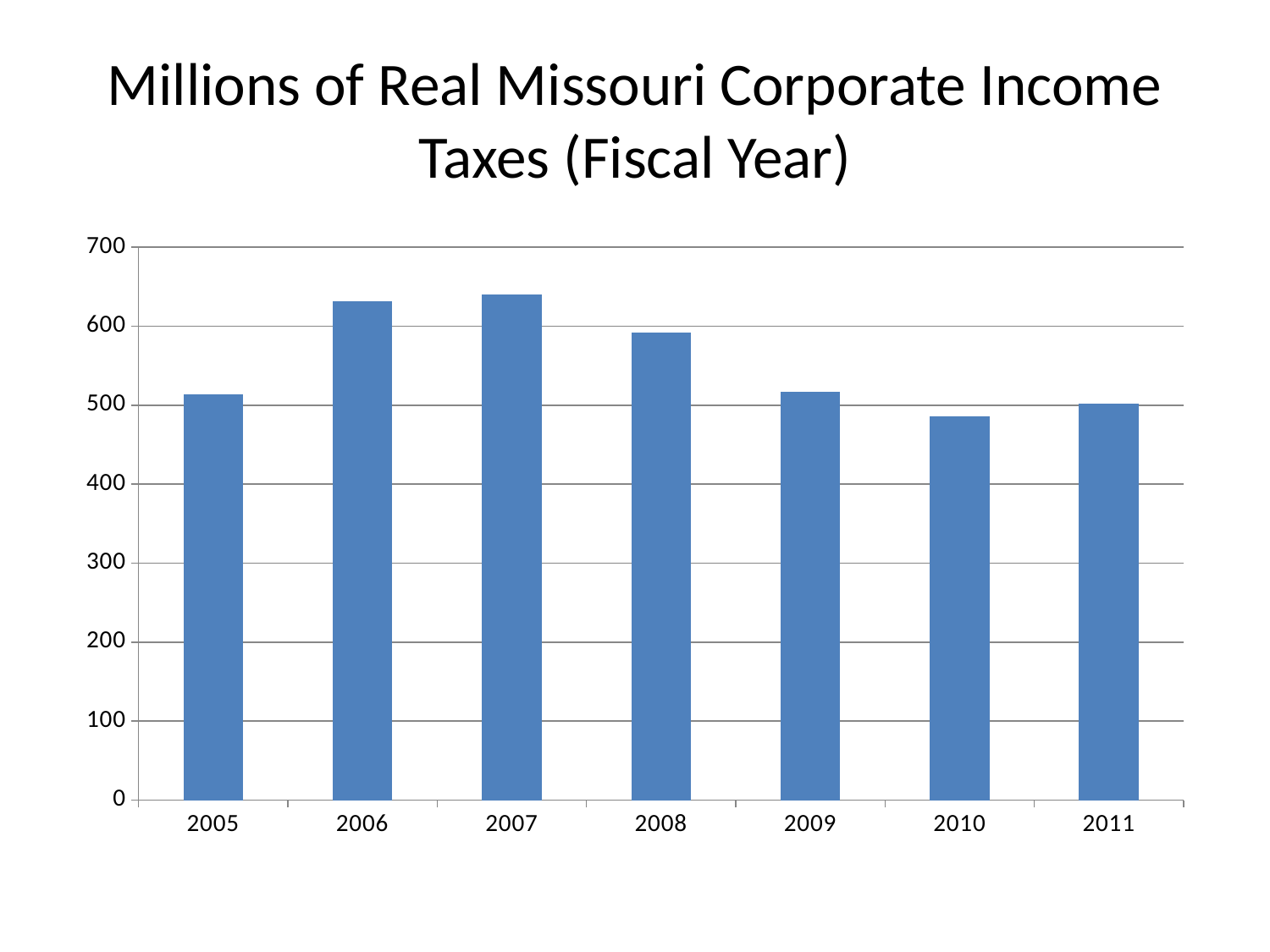
Which is larger, the value for 2006 or the value for 2009? 2006 Is the value for 2009 greater or less than 500? greater Which is larger, the value for 2005 or the value for 2008? 2008 What kind of chart is shown on the slide? Bar chart Do the values rise or fall from 2007 to 2010? fall Which fiscal year has the highest value in the chart? 2007 What is the title of the chart? Millions of Real Missouri Corporate Income Taxes (Fiscal Year) Is the value for 2006 greater or less than 600? greater Is the value for 2010 greater or less than 500? less How many fiscal years are shown on the x axis of the chart? 7 Which fiscal year has the lowest value in the chart? 2010